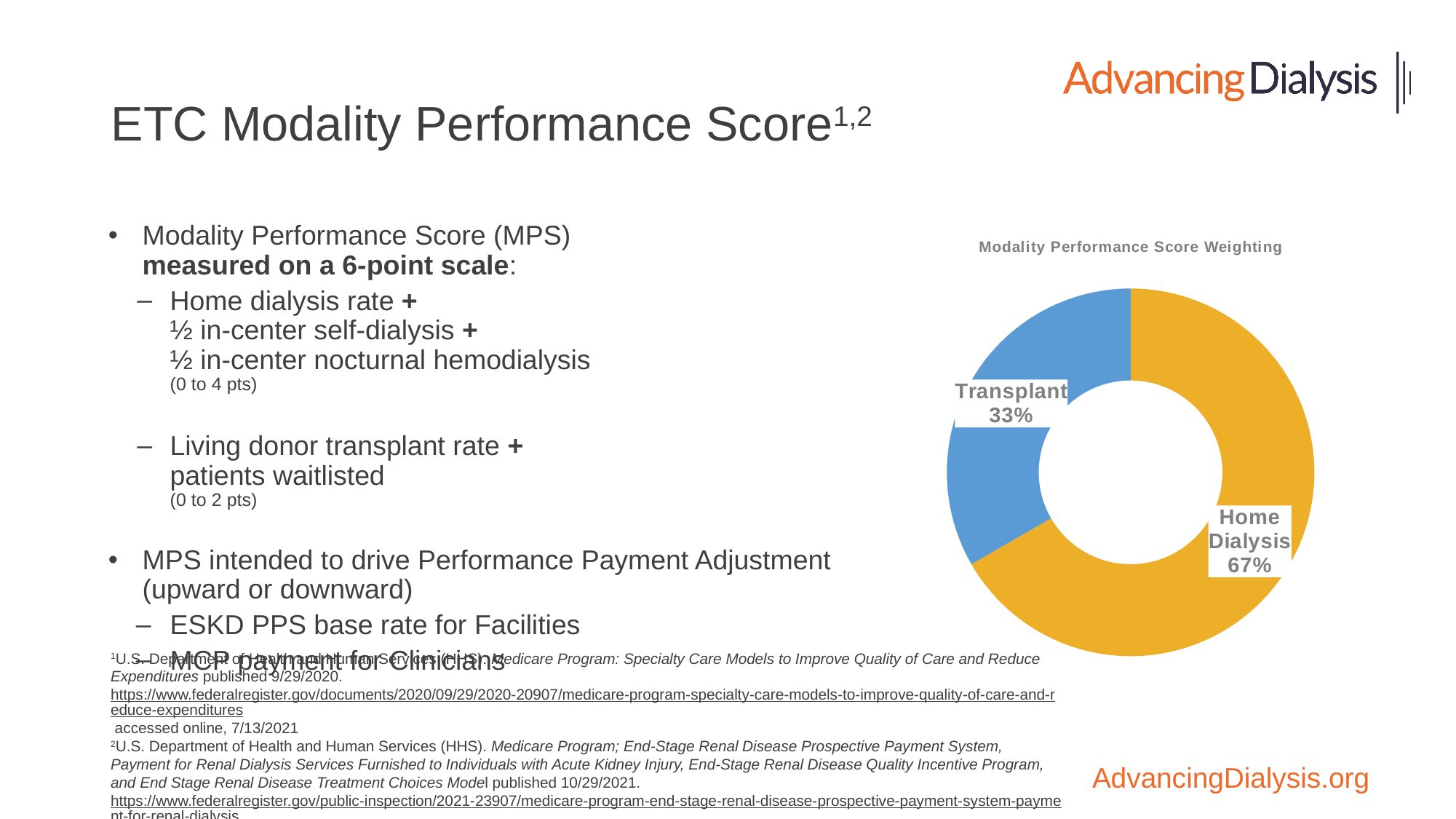
What kind of chart is shown on the slide? Pie chart (doughnut) What share of the Modality Performance Score Weighting chart is Transplant? 33% How many slices does the Modality Performance Score Weighting chart have? 2 What colour is the Home Dialysis slice in the chart? Orange/yellow What share of the Modality Performance Score Weighting chart is Home Dialysis? 67% What is the title of the chart on the slide? Modality Performance Score Weighting Which slice of the Modality Performance Score Weighting chart is the largest? Home Dialysis What is the difference in percentage points between the Home Dialysis and Transplant slices? 34 percentage points Which slice of the Modality Performance Score Weighting chart is the smallest? Transplant Which is larger in the Modality Performance Score Weighting chart, Transplant or Home Dialysis? Home Dialysis